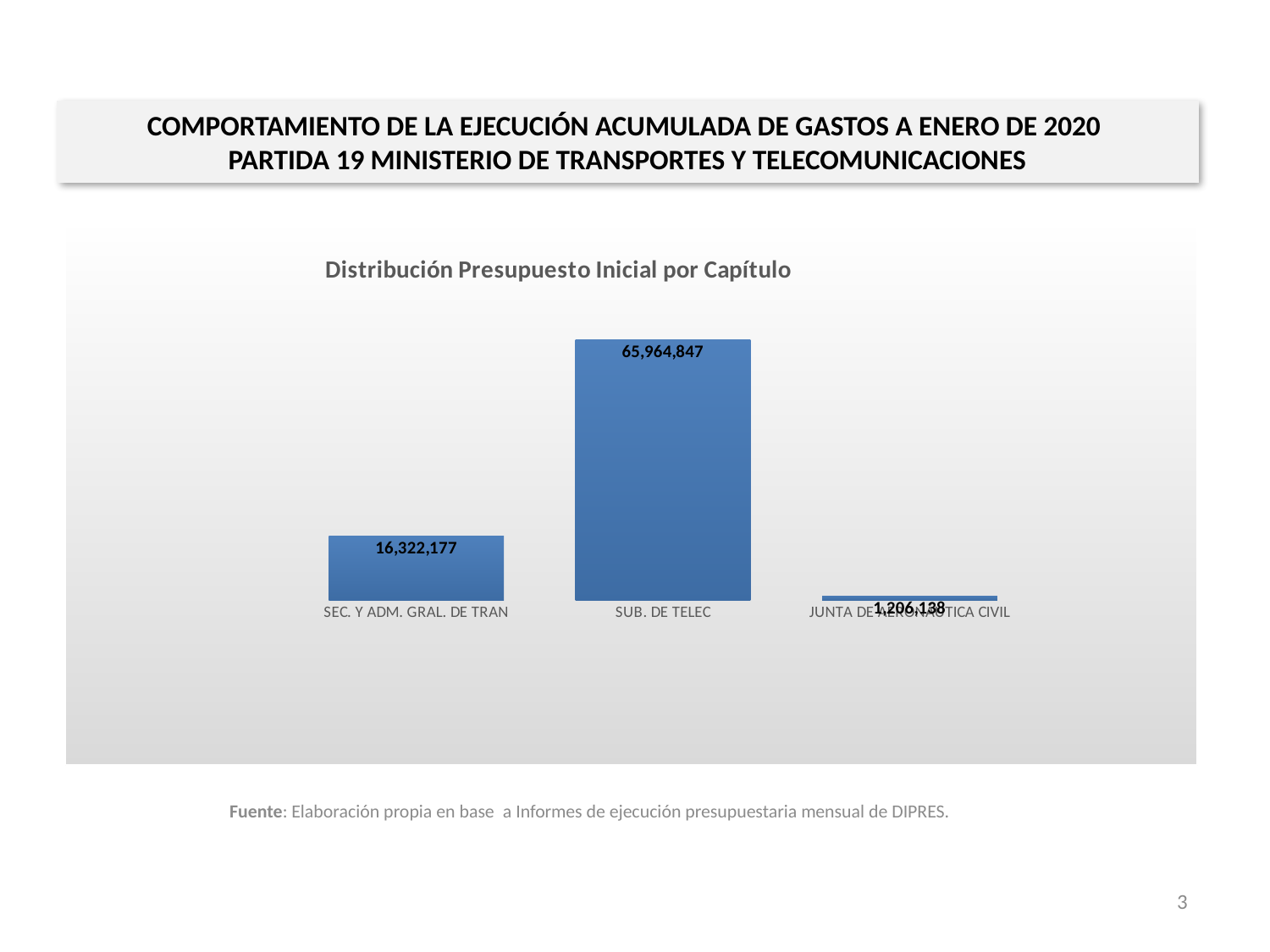
What kind of chart is shown on the slide? Bar chart What is the value for SEC. Y ADM. GRAL. DE TRAN? 16,322,177 What is the title of the chart? Distribución Presupuesto Inicial por Capítulo What is the difference between the values for SUB. DE TELEC and SEC. Y ADM. GRAL. DE TRAN? 49,642,670 What colour are the bars in the chart? Blue Which is larger, the value for SEC. Y ADM. GRAL. DE TRAN or the value for JUNTA DE AERONÁUTICA CIVIL? SEC. Y ADM. GRAL. DE TRAN What is the difference between the values for SEC. Y ADM. GRAL. DE TRAN and JUNTA DE AERONÁUTICA CIVIL? 15,116,039 Which category has the highest value? SUB. DE TELEC What is the value for SUB. DE TELEC? 65,964,847 How many categories are shown in the chart? 3 Which category has the lowest value? JUNTA DE AERONÁUTICA CIVIL What is the value for JUNTA DE AERONÁUTICA CIVIL? 1,206,138